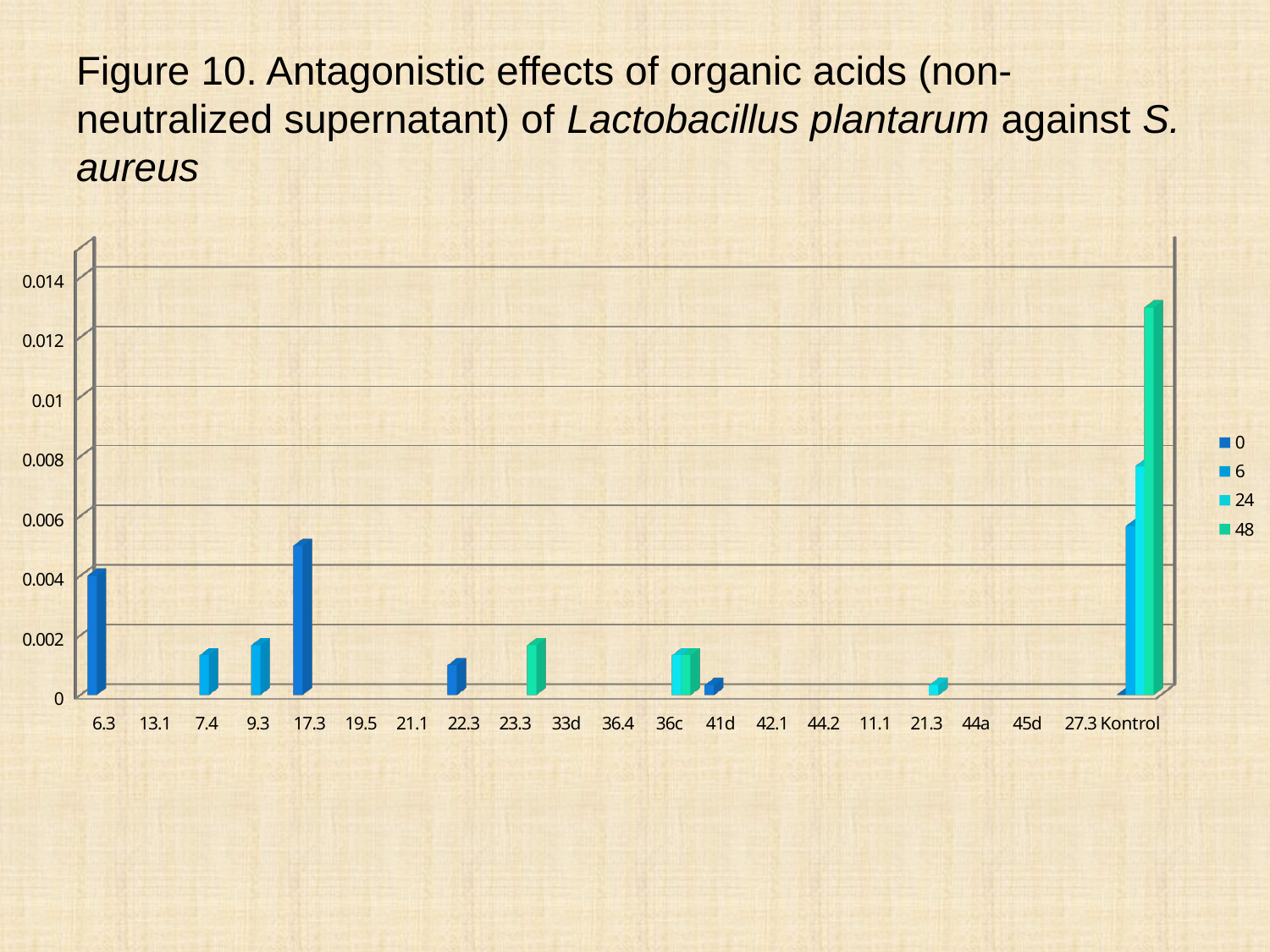
Is the value for the 48 series at Kontrol greater or less than 0.01? greater What are the entries listed in the legend? 0, 6, 24, 48 Is the value for the 0 series at 17.3 greater or less than 0.006? less Which category has the tallest bar in the chart? Kontrol For the 0 series, which is larger: the value at 17.3 or the value at 6.3? 17.3 How many series does the legend list? 4 What kind of chart is shown on the slide? bar chart What is the label of the last category on the x axis? Kontrol At Kontrol, which series has the larger value: 48 or 24? 48 Is the value for the 0 series at 6.3 greater or less than 0.006? less How many categories are shown along the x axis? 21